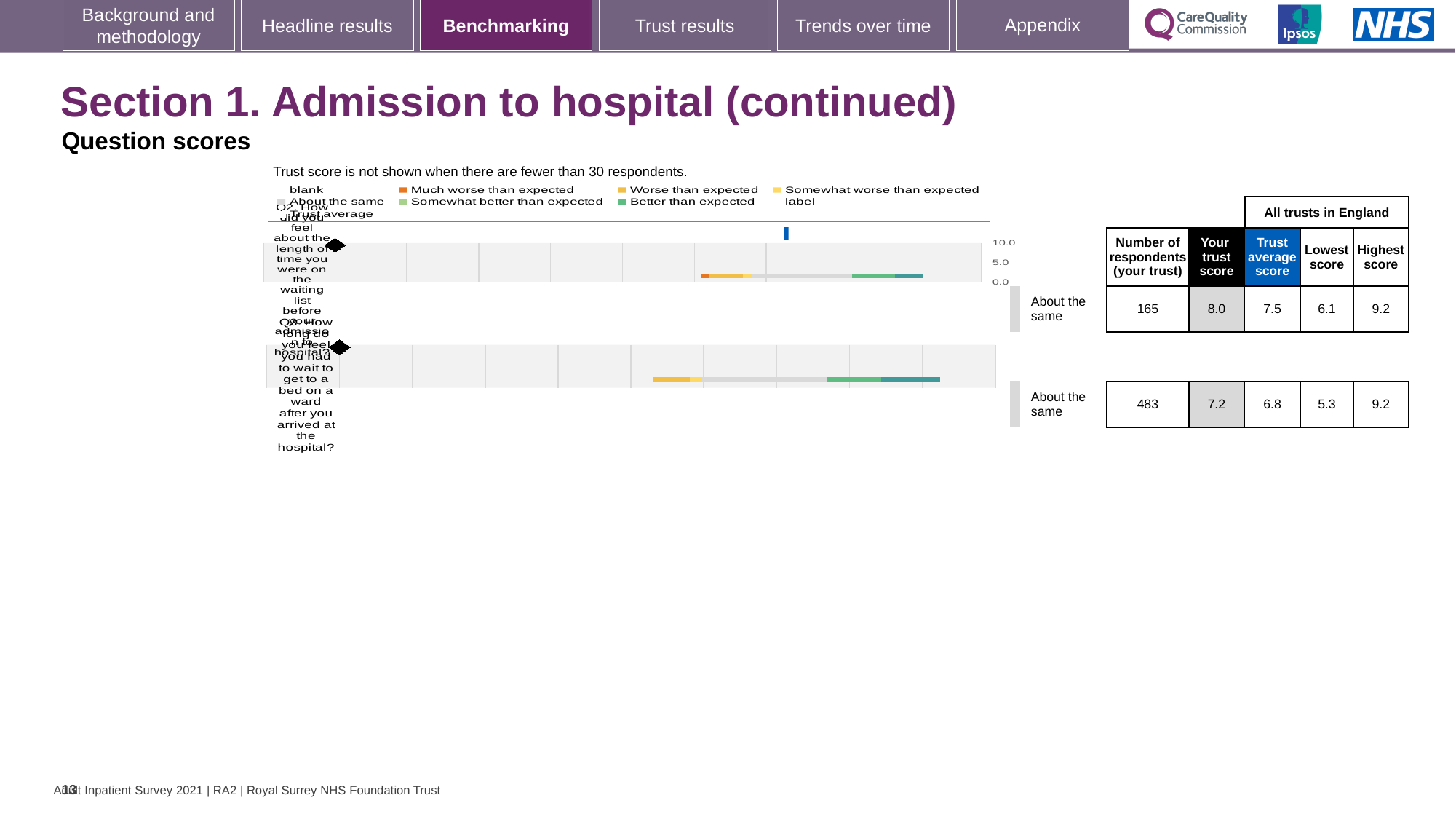
What benchmark category is shown for the trust on both Q2 and Q3? About the same What is the lowest score across all trusts in England for Q2? 6.1 How many respondents from the trust answered Q3? 483 Which question has the higher trust score, Q2 or Q3? Q2 What kind of chart is used to show the question scores? Bar chart What is the difference between the trust score and the trust average score for Q2? 0.5 What is the trust average score across all trusts in England for Q3? 6.8 What is the trust score for Q3 (how long did you feel you had to wait to get to a bed on a ward after you arrived at the hospital)? 7.2 What is the trust score for Q2 (how did you feel about the length of time you were on the waiting list before admission to hospital)? 8.0 How many questions are plotted on the chart? 2 How many respondents from the trust answered Q2? 165 Which legend entry is shown in orange? Much worse than expected